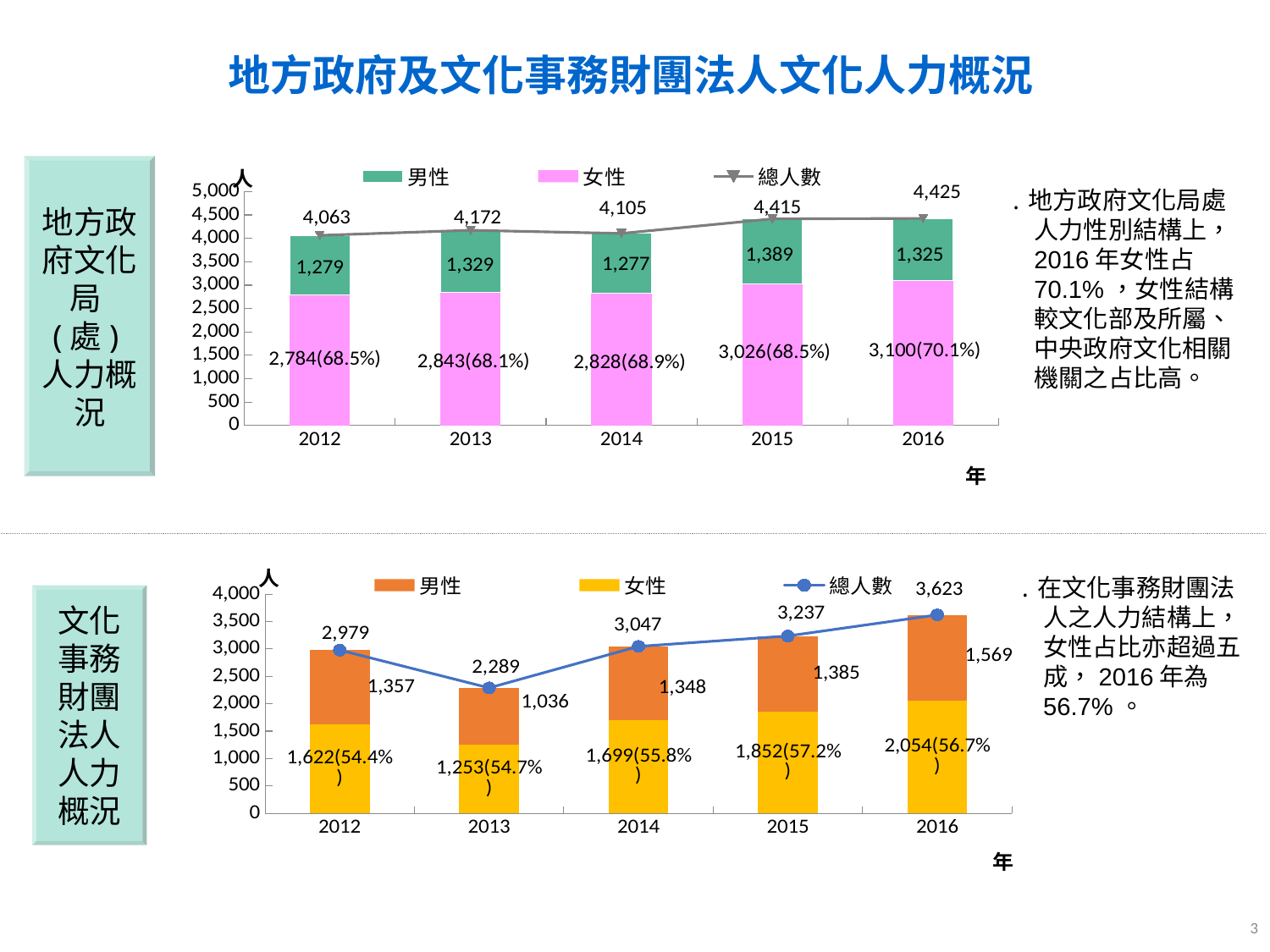
In the top chart (地方政府文化局(處)人力概況), how many series does the legend list? 3 In the bottom chart (文化事務財團法人人力概況), what is the 男性 value for 2016? 1,569 In the bottom chart (文化事務財團法人人力概況), which year has the highest 總人數? 2016 In the bottom chart (文化事務財團法人人力概況), what is the 總人數 value for 2013? 2,289 What kind of chart is the bottom chart (文化事務財團法人人力概況)? Stacked bar chart with a line In the bottom chart (文化事務財團法人人力概況), how many years are shown on the x axis? 5 In the top chart (地方政府文化局(處)人力概況), what is the 男性 value for 2015? 1,389 In the top chart (地方政府文化局(處)人力概況), which year has the lowest 總人數? 2012 In the top chart (地方政府文化局(處)人力概況), what is the 總人數 value for 2016? 4,425 In the top chart (地方政府文化局(處)人力概況), what percentage is shown next to the 女性 value for 2016? 70.1% In the bottom chart (文化事務財團法人人力概況), is the 男性 value for 2013 larger or smaller than the 男性 value for 2014? smaller In the top chart (地方政府文化局(處)人力概況), what is the difference between the 總人數 values for 2015 and 2014? 310